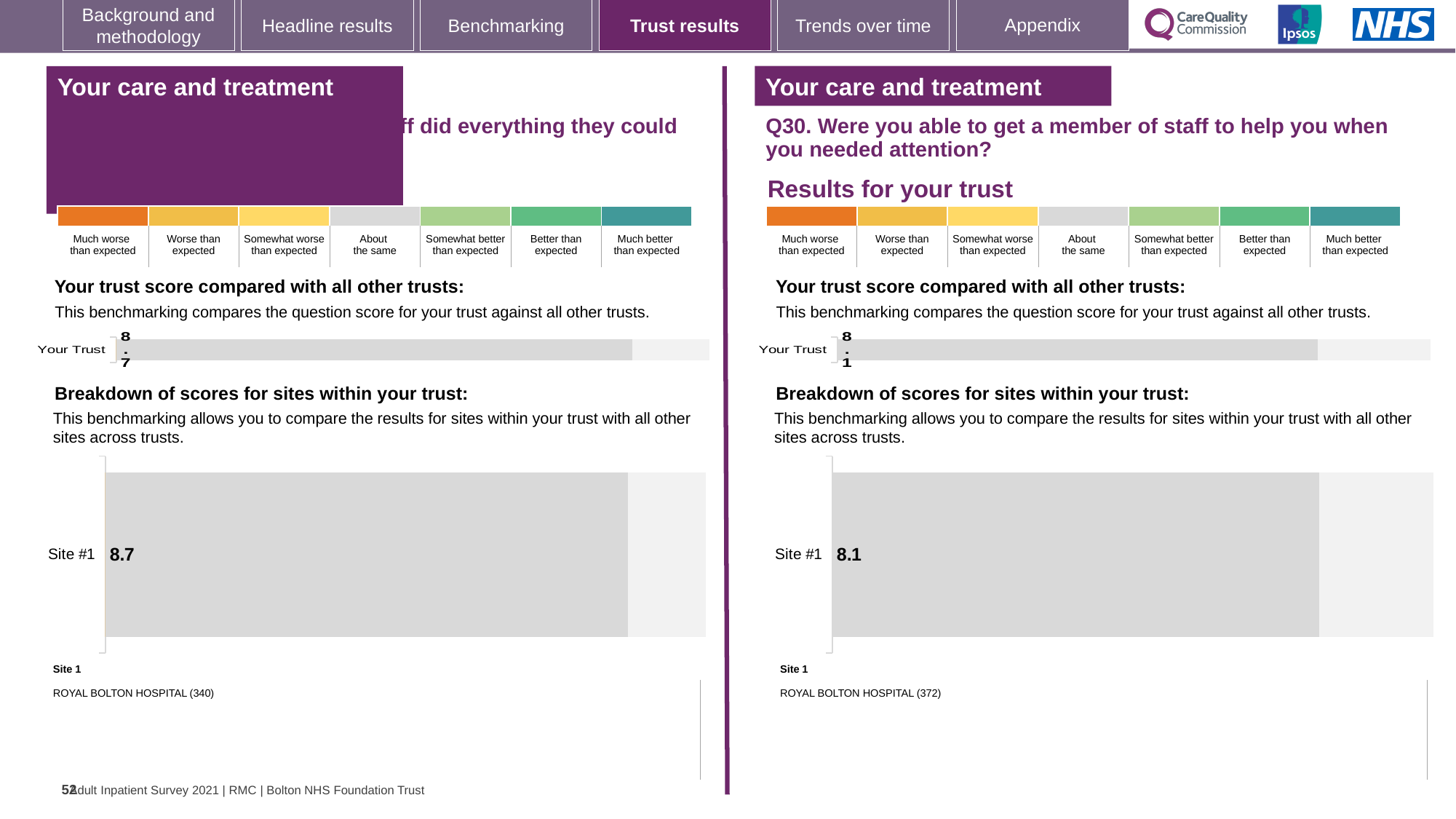
Which is larger: the Your Trust score on the left panel or the Your Trust score on the right panel (Q30)? Left panel (8.7) What is the difference between the Site #1 score on the left panel (8.7) and the Site #1 score on the right panel (8.1)? 0.6 On the left panel, what score is shown for Site #1 in the 'Breakdown of scores for sites within your trust' chart? 8.7 On the left panel, what is the score shown for Your Trust in the 'Your trust score compared with all other trusts' chart? 8.7 How many sites are shown in the 'Breakdown of scores for sites within your trust' chart on the left panel? 1 Is the Your Trust score on the right panel (Q30) greater or less than 8.5? less Which hospital is listed as Site 1 on the right panel (Q30), and how many respondents are shown in brackets? ROYAL BOLTON HOSPITAL (372) On the right panel (Q30), what score is shown for Site #1 in the 'Breakdown of scores for sites within your trust' chart? 8.1 On the right panel (Q30), what is the score shown for Your Trust in the 'Your trust score compared with all other trusts' chart? 8.1 How many respondents are shown in brackets for ROYAL BOLTON HOSPITAL as Site 1 on the left panel? 340 What kind of chart is used to show the Site #1 score on the right panel (Q30)? Bar chart How many sites are shown in the 'Breakdown of scores for sites within your trust' chart on the right panel (Q30)? 1